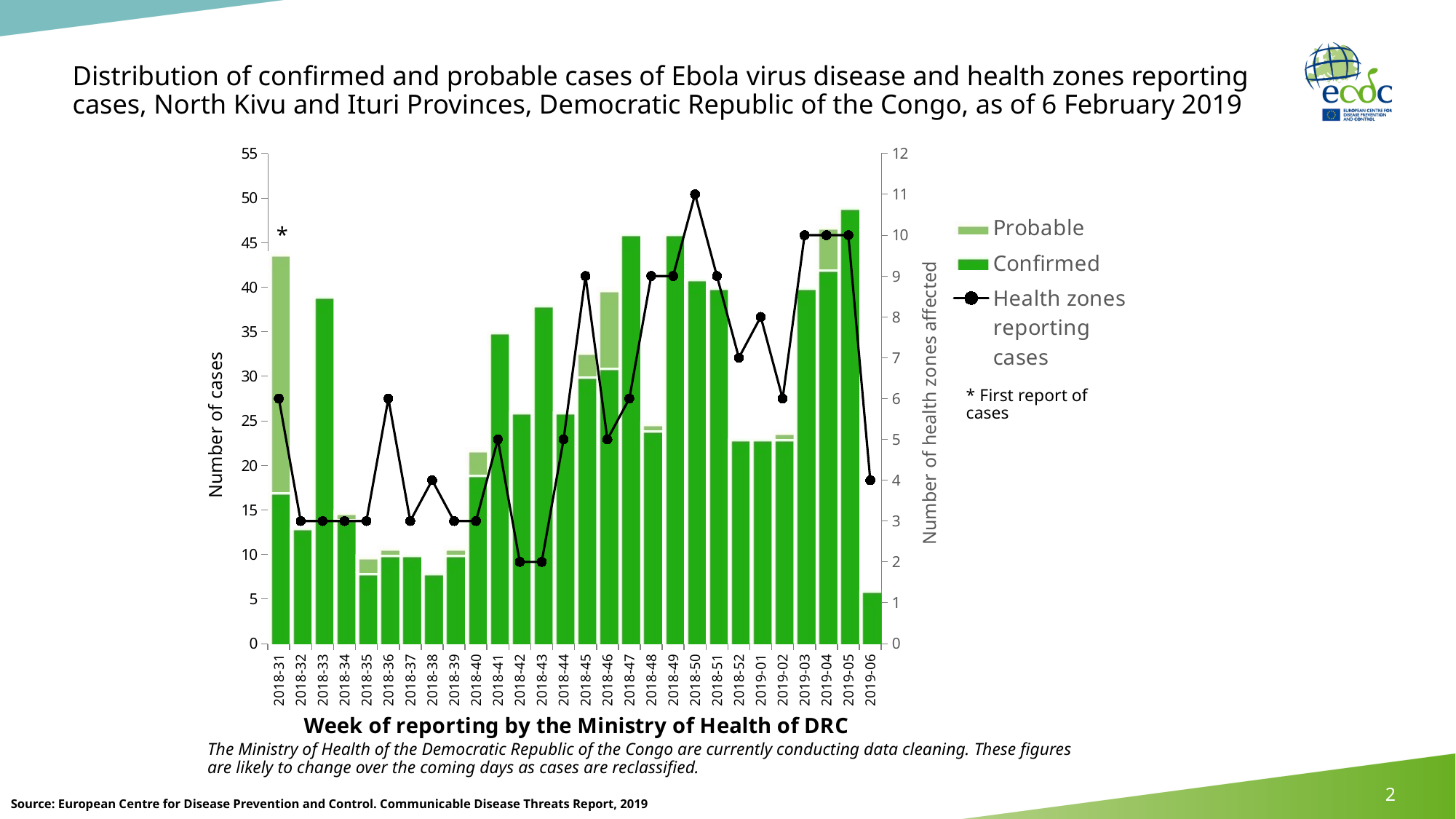
Which week has a taller total bar, 2018-33 or 2018-32? 2018-33 What does the asterisk above the first bar indicate? First report of cases Is the number of confirmed cases in week 2019-06 greater or less than 10? less How many health zones were reporting cases in week 2018-50? 11 How many weeks are shown on the x axis? 28 How many health zones were reporting cases in week 2018-42? 2 In which week was the number of health zones reporting cases highest? 2018-50 Is the total number of cases in week 2019-05 greater or less than 45? greater How many series does the legend list? 3 What is the difference in the number of health zones reporting cases between week 2018-50 and week 2019-06? 7 How many health zones were reporting cases in week 2019-06? 4 What kind of chart is shown on the slide? A bar chart combined with a line chart